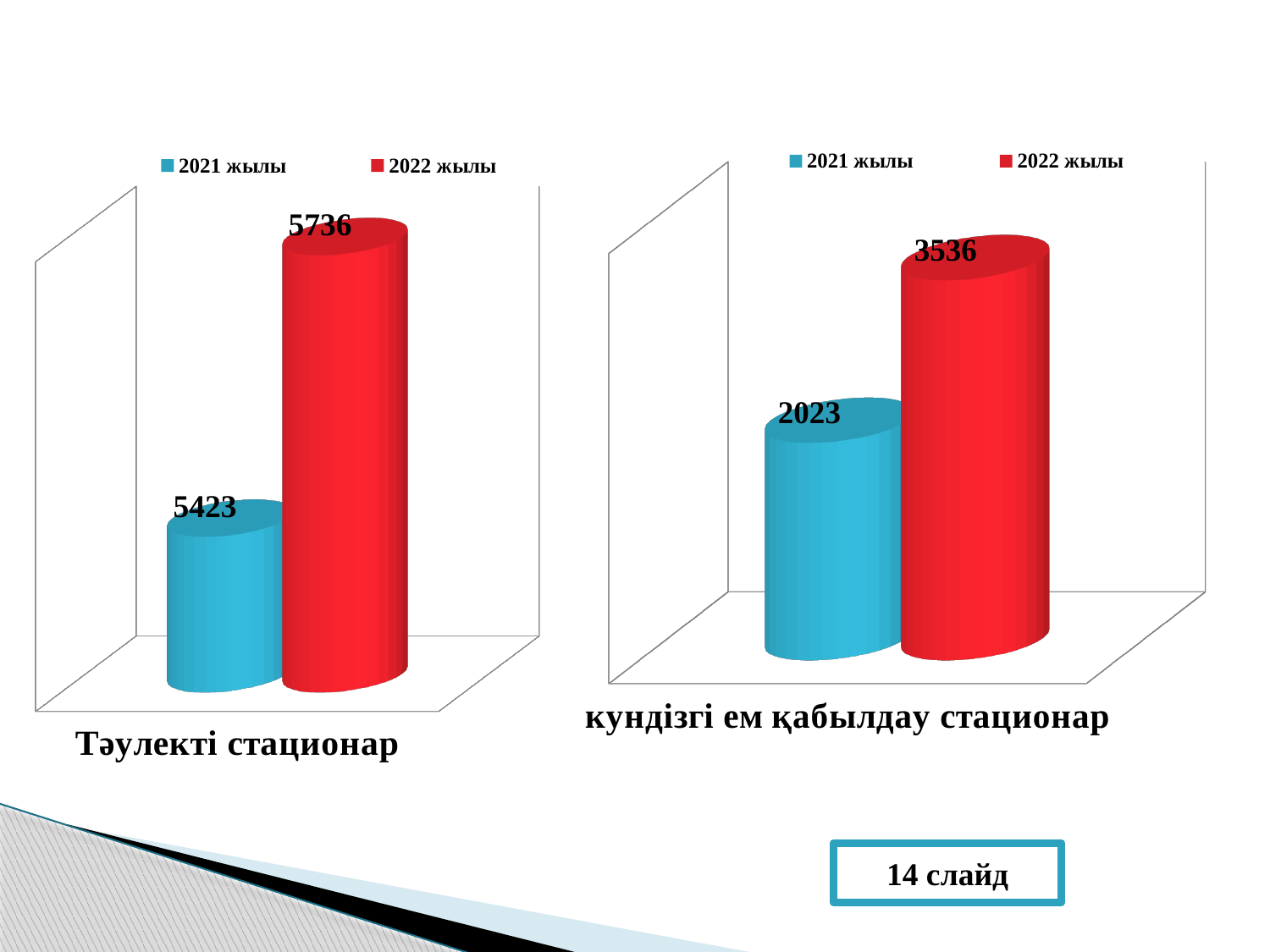
In the left chart (Тәулекті стационар), what is the difference between the 2022 жылы and 2021 жылы values? 313 In the right chart (кундізгі ем қабылдау стационар), what is the value for 2021 жылы? 2023 In the left chart (Тәулекті стационар), what is the value for 2021 жылы? 5423 In the right chart (кундізгі ем қабылдау стационар), is the value for 2022 жылы larger or smaller than the value for 2021 жылы? larger In the right chart (кундізгі ем қабылдау стационар), which year has the lower value? 2021 жылы In the right chart (кундізгі ем қабылдау стационар), what is the value for 2022 жылы? 3536 What kind of chart is the right chart (кундізгі ем қабылдау стационар)? bar chart In the left chart (Тәулекті стационар), which colour represents 2022 жылы? red In the left chart (Тәулекті стационар), which year has the higher value? 2022 жылы In the right chart (кундізгі ем қабылдау стационар), what is the difference between the 2022 жылы and 2021 жылы values? 1513 In the left chart (Тәулекті стационар), what is the value for 2022 жылы? 5736 How many series does the legend of the left chart (Тәулекті стационар) list? 2